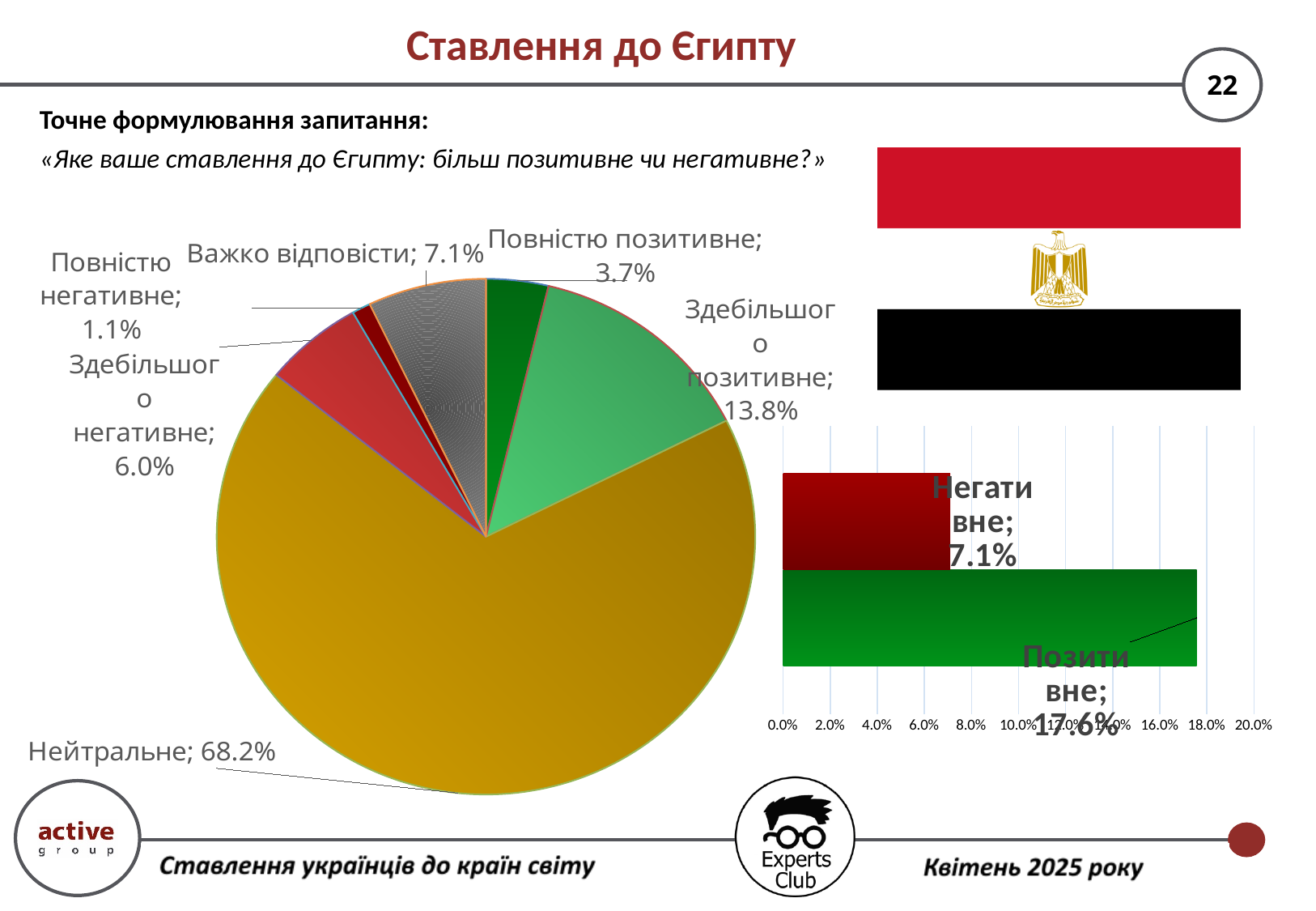
On the pie chart, what share is labelled for Здебільшого позитивне? 13.8% On the bar chart on the right, what is the difference between Позитивне and Негативне? 10.5% On the pie chart, which category has the largest slice? Нейтральне On the pie chart, what share is labelled for Нейтральне? 68.2% On the pie chart, how many slices are there? 6 On the pie chart, what share is labelled for Повністю негативне? 1.1% On the pie chart, which is larger: Важко відповісти or Повністю позитивне? Важко відповісти On the bar chart on the right, what is the value for Позитивне? 17.6% What kind of chart is shown on the right side of the slide? Bar chart On the pie chart, what is the difference between Здебільшого позитивне and Здебільшого негативне? 7.8% On the pie chart, which category has the smallest slice? Повністю негативне On the bar chart on the right, what is the value for Негативне? 7.1%